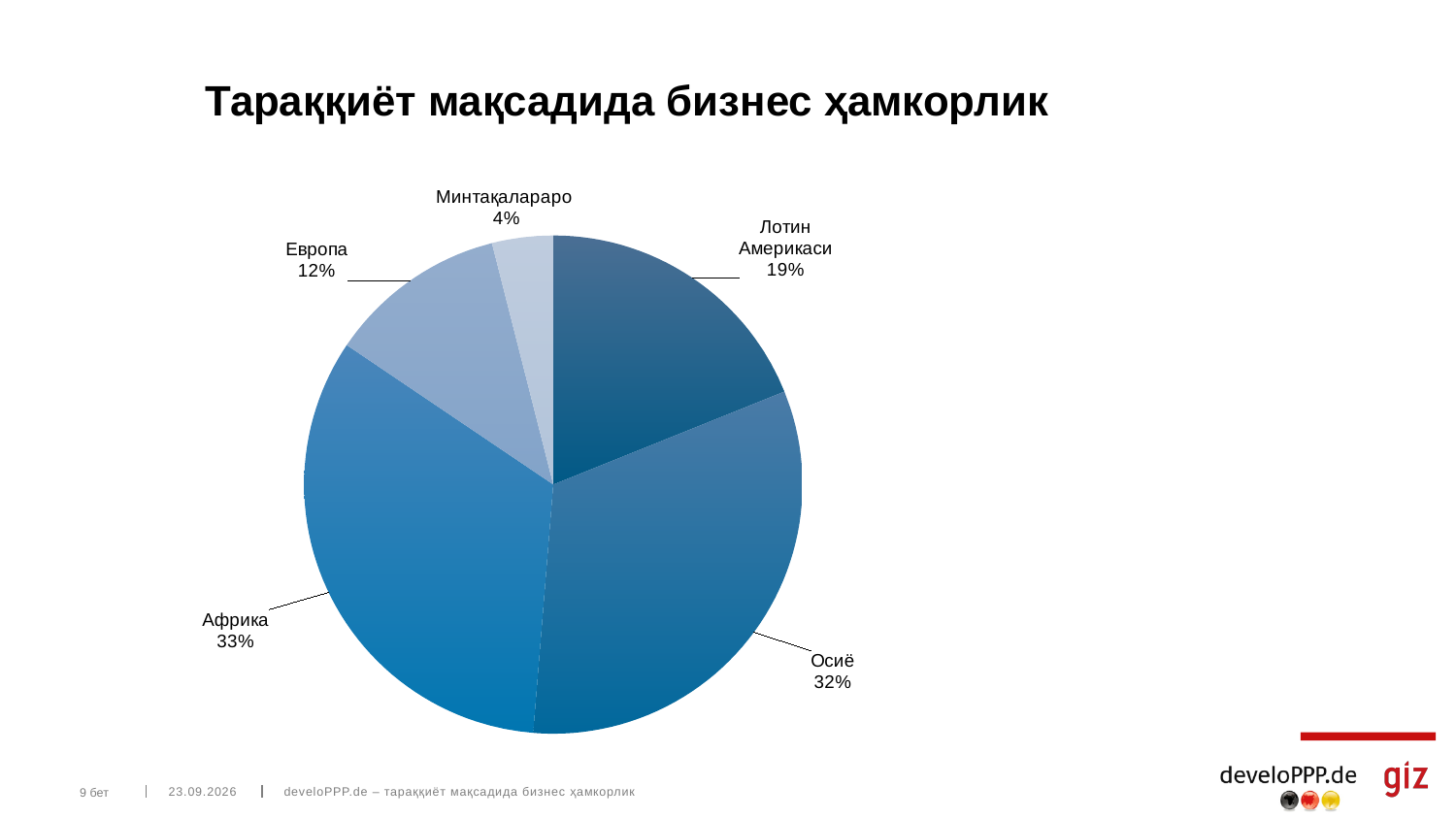
What share does Минтақалараро have? 4% Which region has the largest slice of the pie? Африка What type of chart is shown on the slide? Pie chart What percentage is shown for Европа? 12% What is the title of the slide containing the chart? Тараққиёт мақсадида бизнес ҳамкорлик Which category has the smallest slice of the pie? Минтақалараро What is the difference in percentage points between Африка and Европа? 21 What share of the pie does Африка account for? 33% How many slices does the pie chart have? 5 What is the value for Лотин Америкаси? 19% What percentage is shown for Осиё? 32% Which is larger, the share for Лотин Америкаси or the share for Европа? Лотин Америкаси